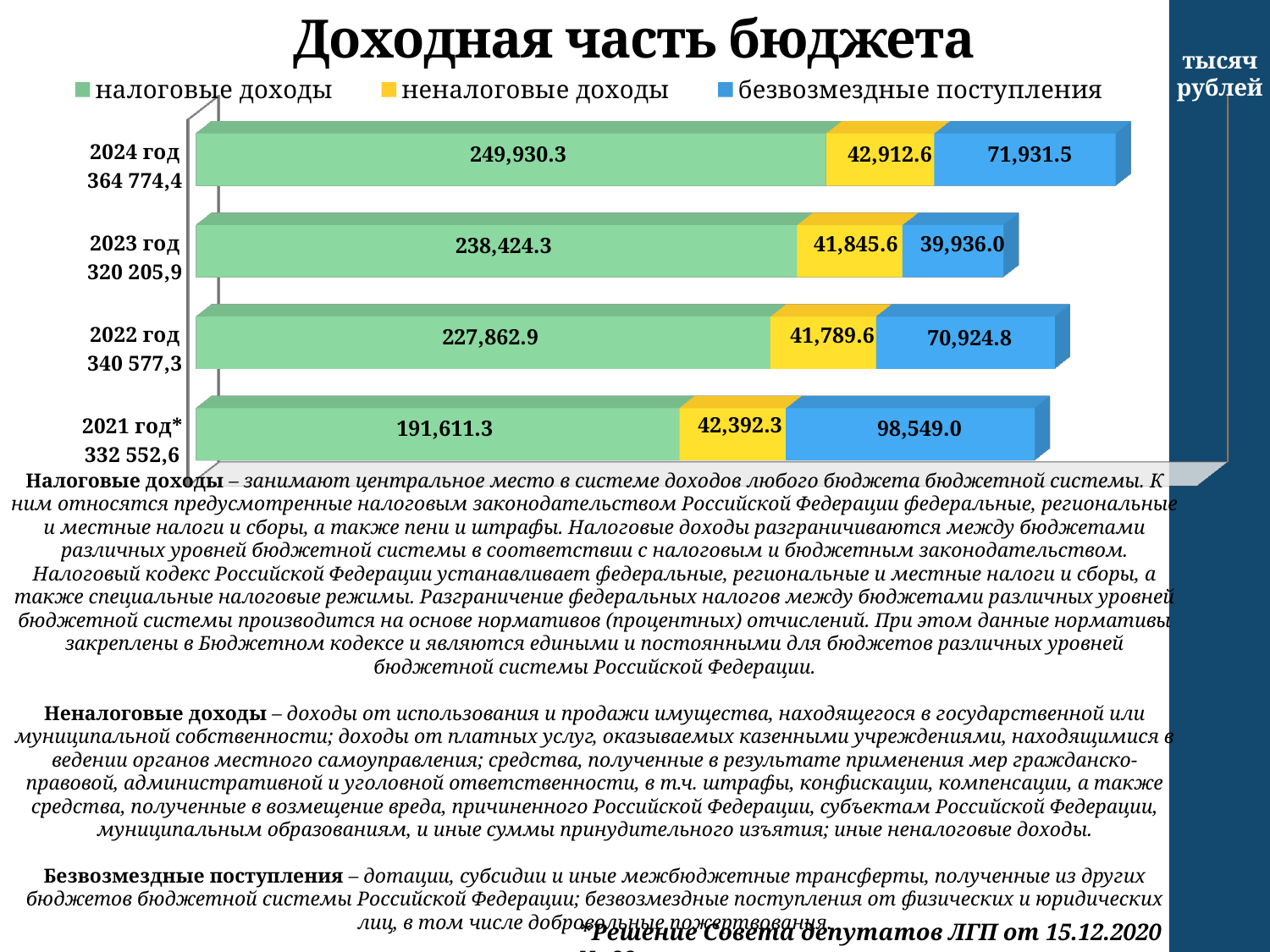
What is the value of безвозмездные поступления for 2023 год? 39,936.0 Which year has the highest value of налоговые доходы? 2024 год What is the value of безвозмездные поступления for 2021 год*? 98,549.0 Which is larger: безвозмездные поступления in 2022 год or in 2024 год? 2024 год What is the value of неналоговые доходы for 2022 год? 41,789.6 What is the value of налоговые доходы for 2024 год? 249,930.3 How many series does the chart legend list? 3 How many years (categories) are shown in the chart? 4 What is the difference between налоговые доходы in 2024 год and 2023 год? 11,506.0 Which year has the lowest value of безвозмездные поступления? 2023 год What is the total of the stacked bar for 2022 год as printed on the slide? 340 577,3 What type of chart is shown on the slide? stacked bar chart